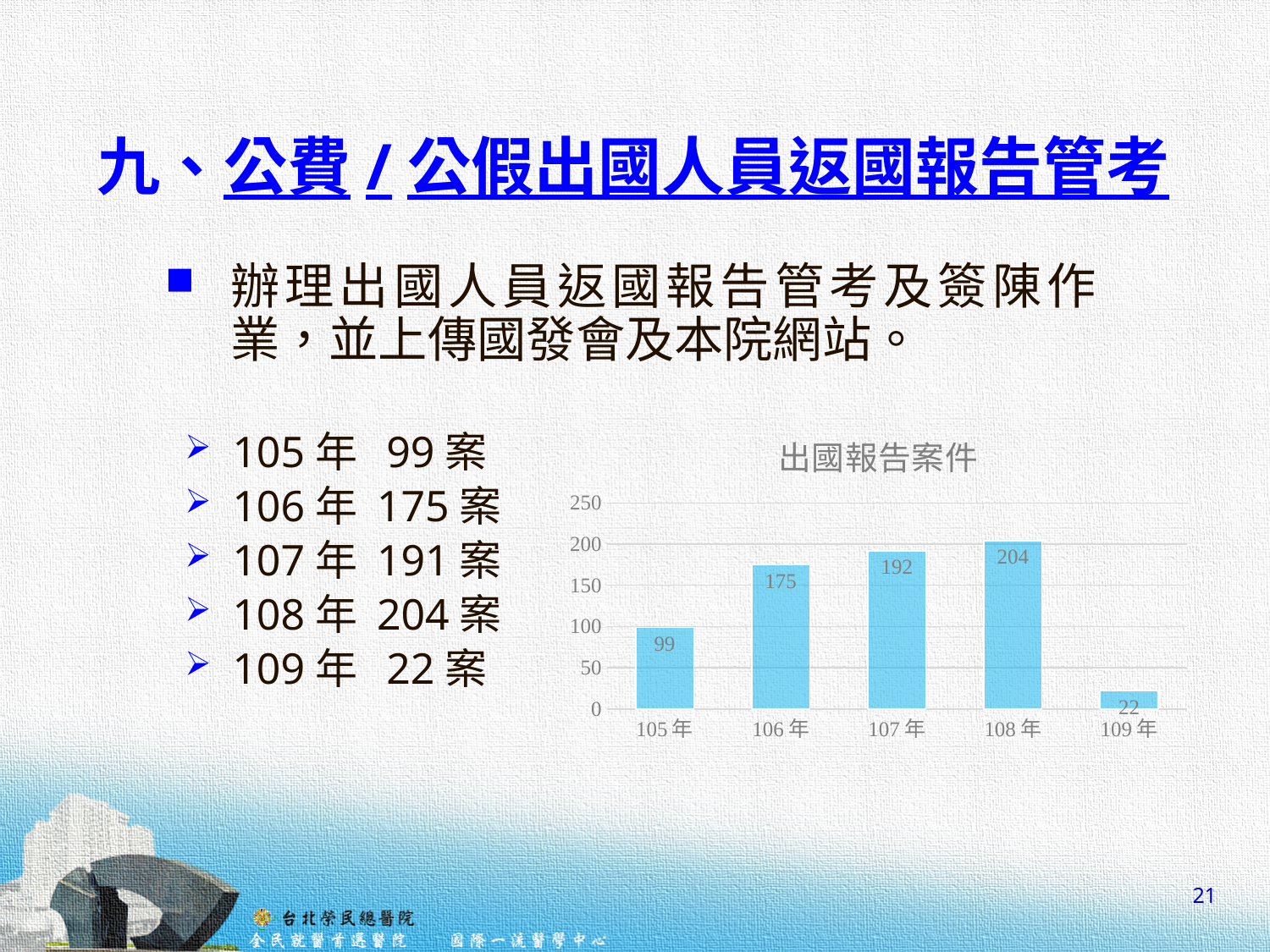
What is the title of the chart? 出國報告案件 How many years are shown on the x axis of the chart? 5 Is the value for 107 年 greater or less than 150? greater Which year has the highest value in the chart? 108 年 What kind of chart is shown on the slide? bar chart What is the value for 108 年 in the chart? 204 What is the value for 109 年 in the chart? 22 Which is larger, the value for 106 年 or the value for 107 年? 107 年 What is the value for 105 年 in the chart? 99 What is the difference between the values for 108 年 and 105 年? 105 Which year has the lowest value in the chart? 109 年 What is the value for 106 年 in the chart? 175